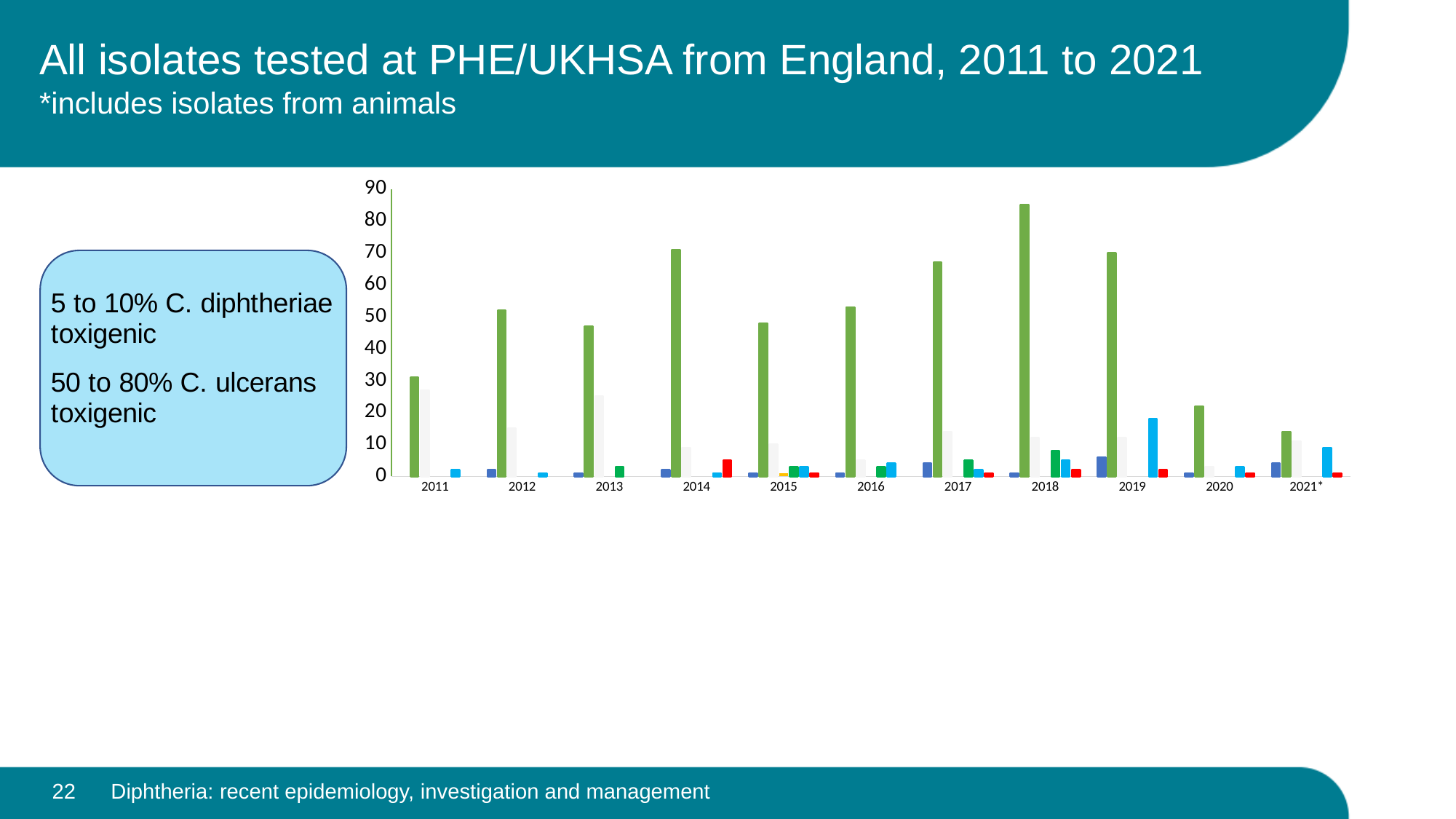
Do the green bars rise or fall from 2019 to 2021*? fall In which year is the green bar the shortest? 2021* What kind of chart is shown on the slide? bar chart Is the value of the green bar for 2021* greater or less than 20? less Which year has the taller green bar, 2013 or 2014? 2014 Is the value of the green bar for 2011 greater or less than 40? less How many years are shown along the x axis of the chart? 11 In which year is the green bar the tallest? 2018 What is the title of the slide containing the chart? All isolates tested at PHE/UKHSA from England, 2011 to 2021 Which year has the taller light blue bar, 2011 or 2019? 2019 Is the value of the green bar for 2018 greater or less than 80? greater